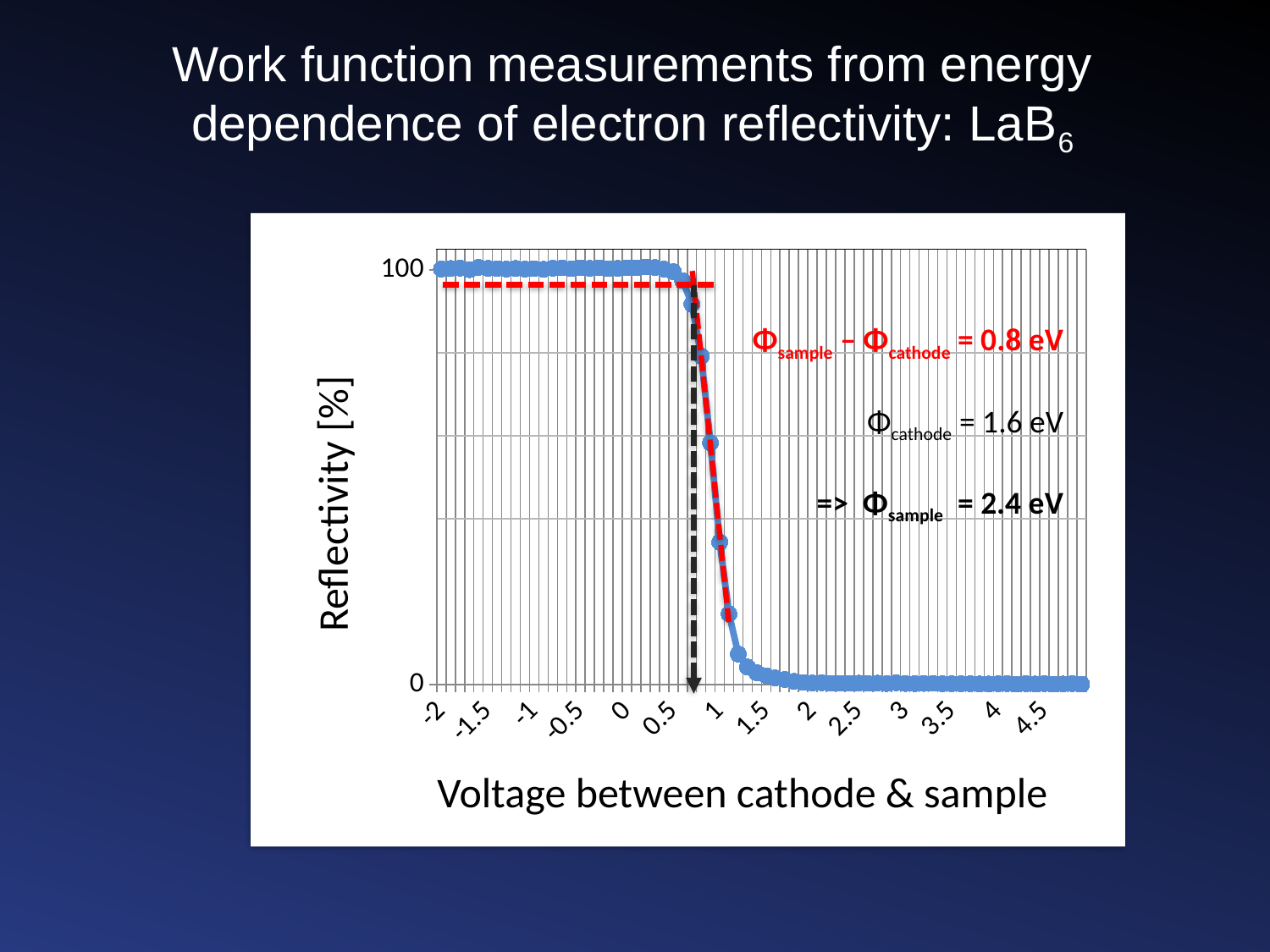
What is the label of the y axis of the chart? Reflectivity [%] What is the highest value labelled on the y axis of the chart? 100 Is the reflectivity at a voltage of -1 greater or less than 0? greater What kind of chart is shown on the slide? line chart According to the annotation on the chart, what is the value of Φsample − Φcathode? 0.8 eV What is the lowest value labelled on the x axis of the chart? -2 Does the reflectivity rise or fall as the voltage increases from -2 to 4.5? fall According to the annotation on the chart, what is the value of Φsample? 2.4 eV According to the annotation on the chart, what is the value of Φcathode? 1.6 eV What is the label of the x axis of the chart? Voltage between cathode & sample Is the reflectivity at a voltage of 3 greater or less than 100? less How many tick labels are shown on the x axis of the chart? 14